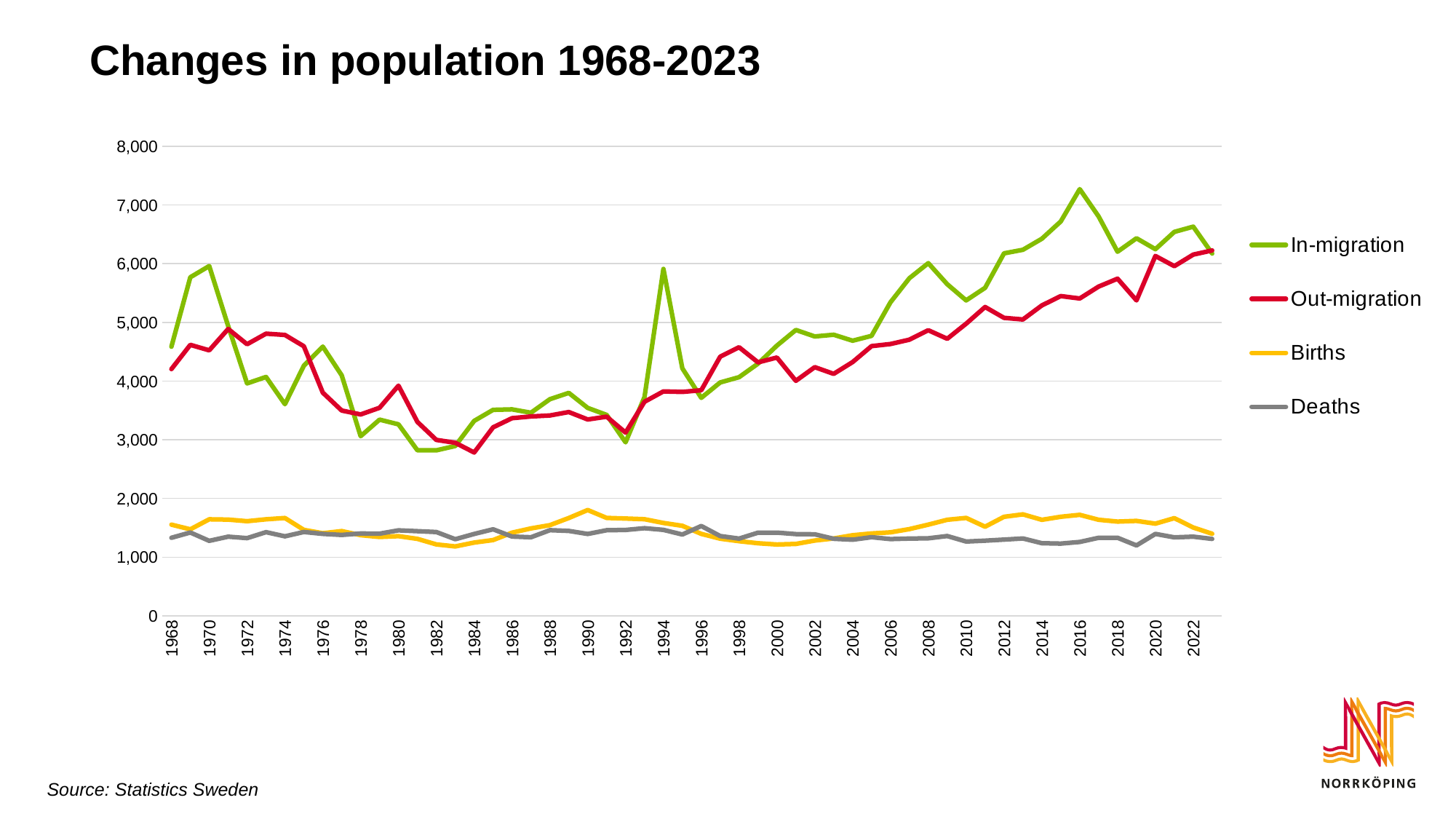
How many series does the legend list? 4 Is the value for Out-migration in 1984 greater or less than 3,000? less In 1994, which is larger, In-migration or Out-migration? In-migration Is the value for In-migration in 1994 greater or less than 5,000? greater Is the value for In-migration in 2016 greater or less than 7,000? greater Which series is drawn in green? In-migration What kind of chart is shown on the slide? line chart Which series has the highest value in 2016? In-migration What is the title of the chart? Changes in population 1968-2023 Which series has the lowest value in 2016? Deaths